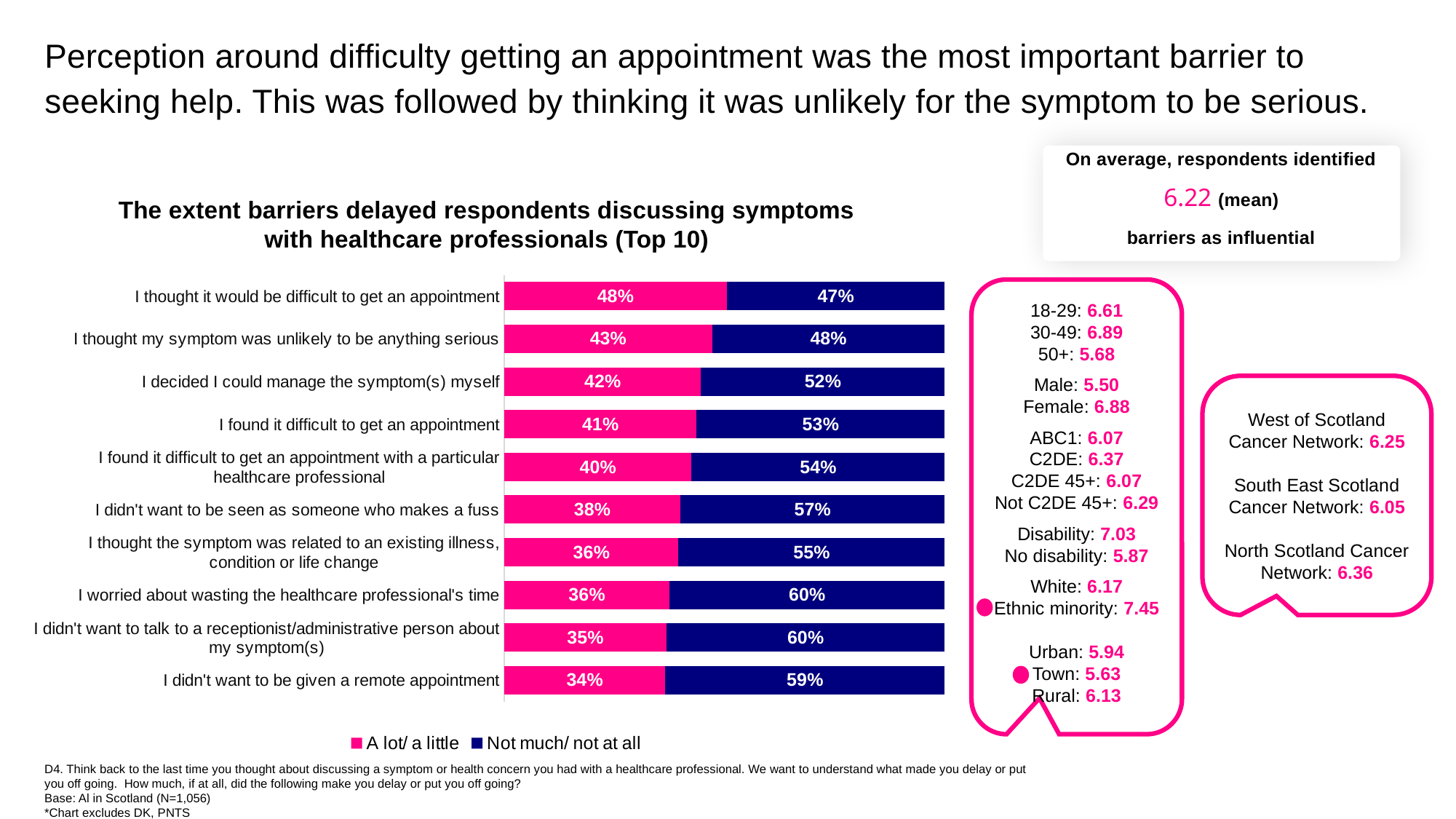
How many barriers are shown in the chart? 10 Which colour represents 'A lot/ a little' in the chart? Pink What is the 'A lot/ a little' value for 'I didn't want to be given a remote appointment'? 34% Which is larger for 'I found it difficult to get an appointment': the 'A lot/ a little' share or the 'Not much/ not at all' share? Not much/ not at all Which barrier has the highest 'A lot/ a little' percentage? I thought it would be difficult to get an appointment What is the 'Not much/ not at all' value for 'I decided I could manage the symptom(s) myself'? 52% What kind of chart is shown on the slide? Stacked horizontal bar chart Which barrier has the lowest 'A lot/ a little' percentage? I didn't want to be given a remote appointment What is the total of the two segments for 'I worried about wasting the healthcare professional's time'? 96% How many series does the legend list? 2 What is the difference between the 'A lot/ a little' and 'Not much/ not at all' values for 'I didn't want to be seen as someone who makes a fuss'? 19 percentage points What percentage of respondents said 'I thought it would be difficult to get an appointment' delayed them a lot/a little? 48%